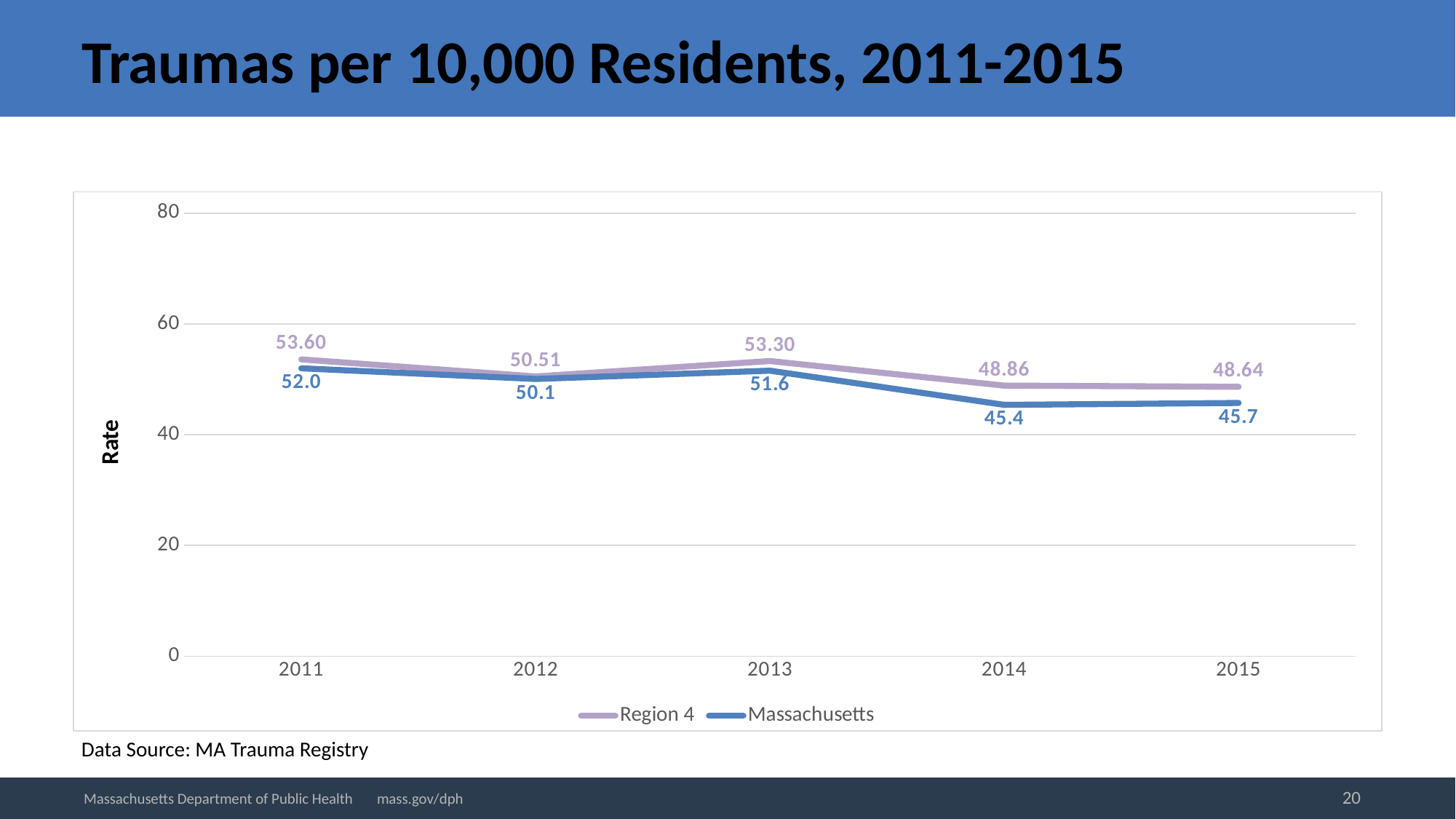
What is the difference between the Region 4 and Massachusetts values in 2014? 3.46 In which year is the Massachusetts value lowest? 2014 How many series does the legend list? 2 How many years are shown on the x axis? 5 What is the Massachusetts value for 2014? 45.4 What is the Region 4 value for 2015? 48.64 Which series has the larger value in 2013, Region 4 or Massachusetts? Region 4 What kind of chart is shown? line chart What is the Region 4 value for 2011? 53.60 Is the Massachusetts value for 2015 greater or less than 40? greater What is the label on the y axis? Rate In which year is the Region 4 value highest? 2011